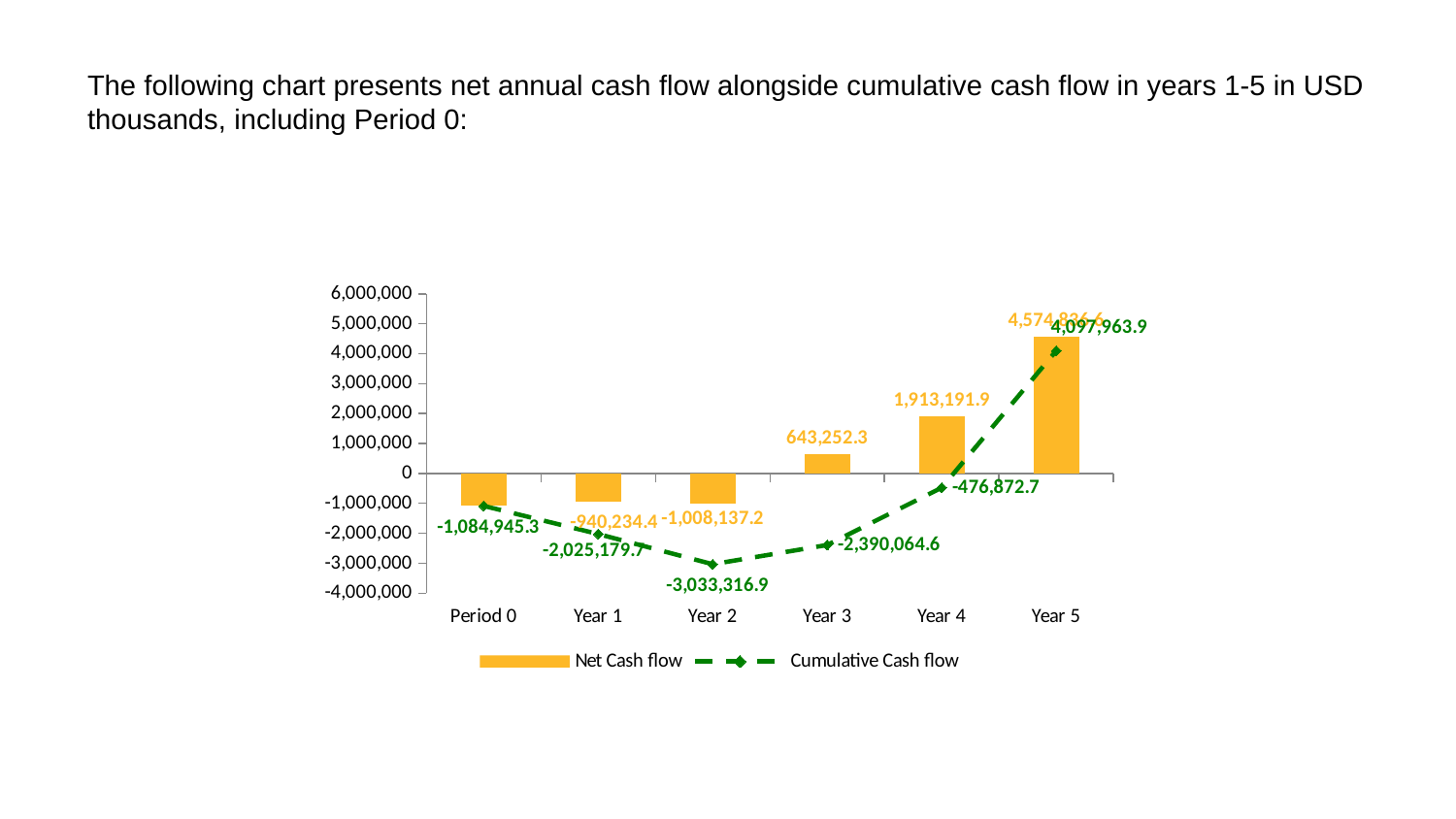
What is the Cumulative Cash flow value for Year 5? 4,097,963.9 What is the Cumulative Cash flow value for Year 2? -3,033,316.9 What is the Net Cash flow value for Year 3? 643,252.3 What is the difference between the Net Cash flow in Year 4 and in Year 3? 1,269,939.6 What is the Net Cash flow value for Year 4? 1,913,191.9 In which period is the Net Cash flow highest? Year 5 In which period is the Cumulative Cash flow lowest? Year 2 Is the Net Cash flow for Year 5 greater or less than 4,000,000? greater What is the Cumulative Cash flow value for Year 4? -476,872.7 Which has the lower Net Cash flow, Year 1 or Year 2? Year 2 How many series does the legend list? 2 How many periods are shown on the x axis? 6